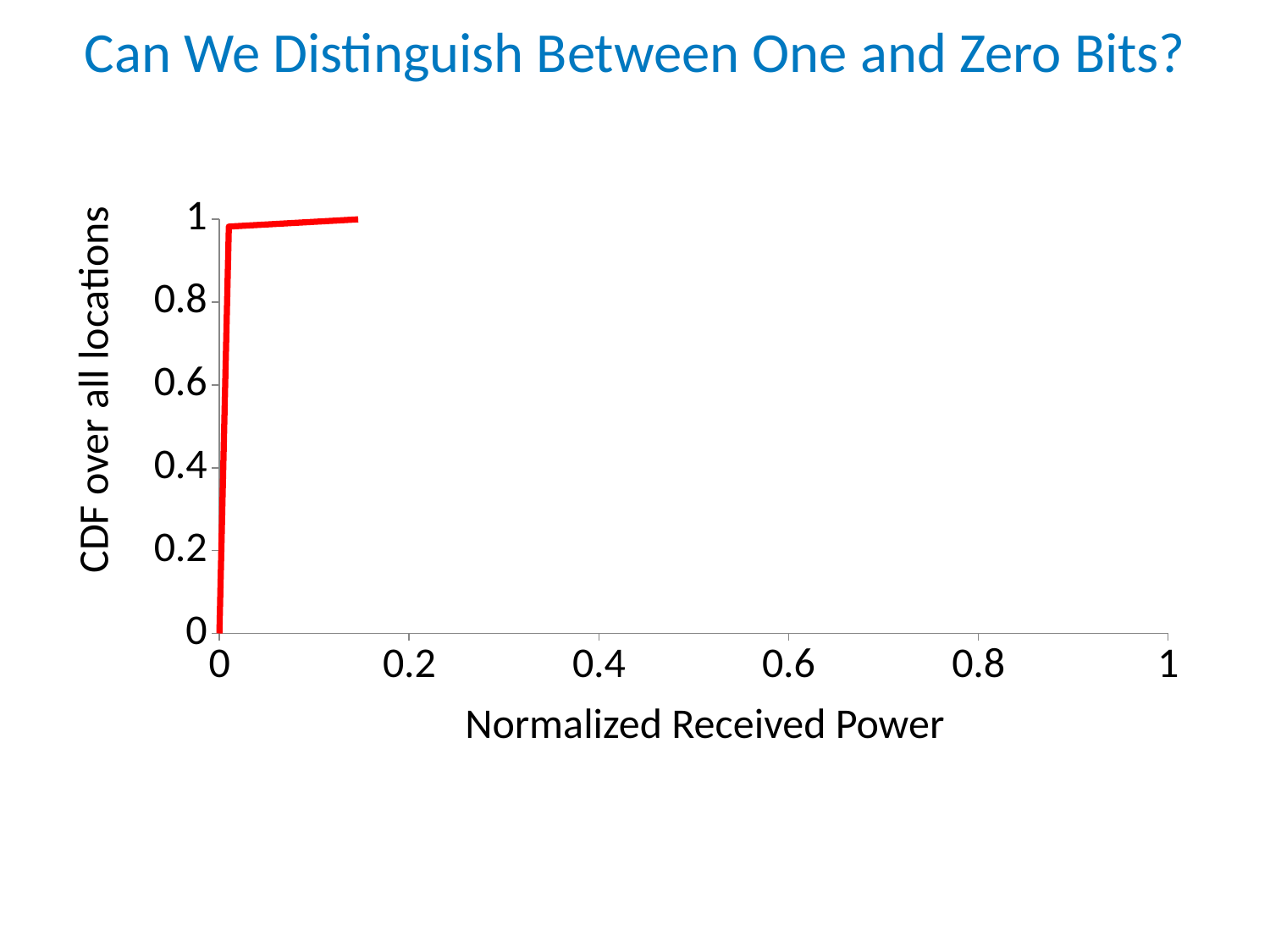
How many lines are plotted on the chart? 1 Does the CDF rise or fall as Normalized Received Power increases along the x axis? rise What is the label of the y axis? CDF over all locations What is the highest tick value shown on the x axis? 1 Is the CDF value at a Normalized Received Power of 0.05 greater or less than 0.6? greater Is the CDF value at a Normalized Received Power of 0.1 greater or less than 0.8? greater Is the Normalized Received Power at which the plotted line ends greater or less than 0.2? less What kind of chart is shown on the slide? line chart What is the label of the x axis? Normalized Received Power